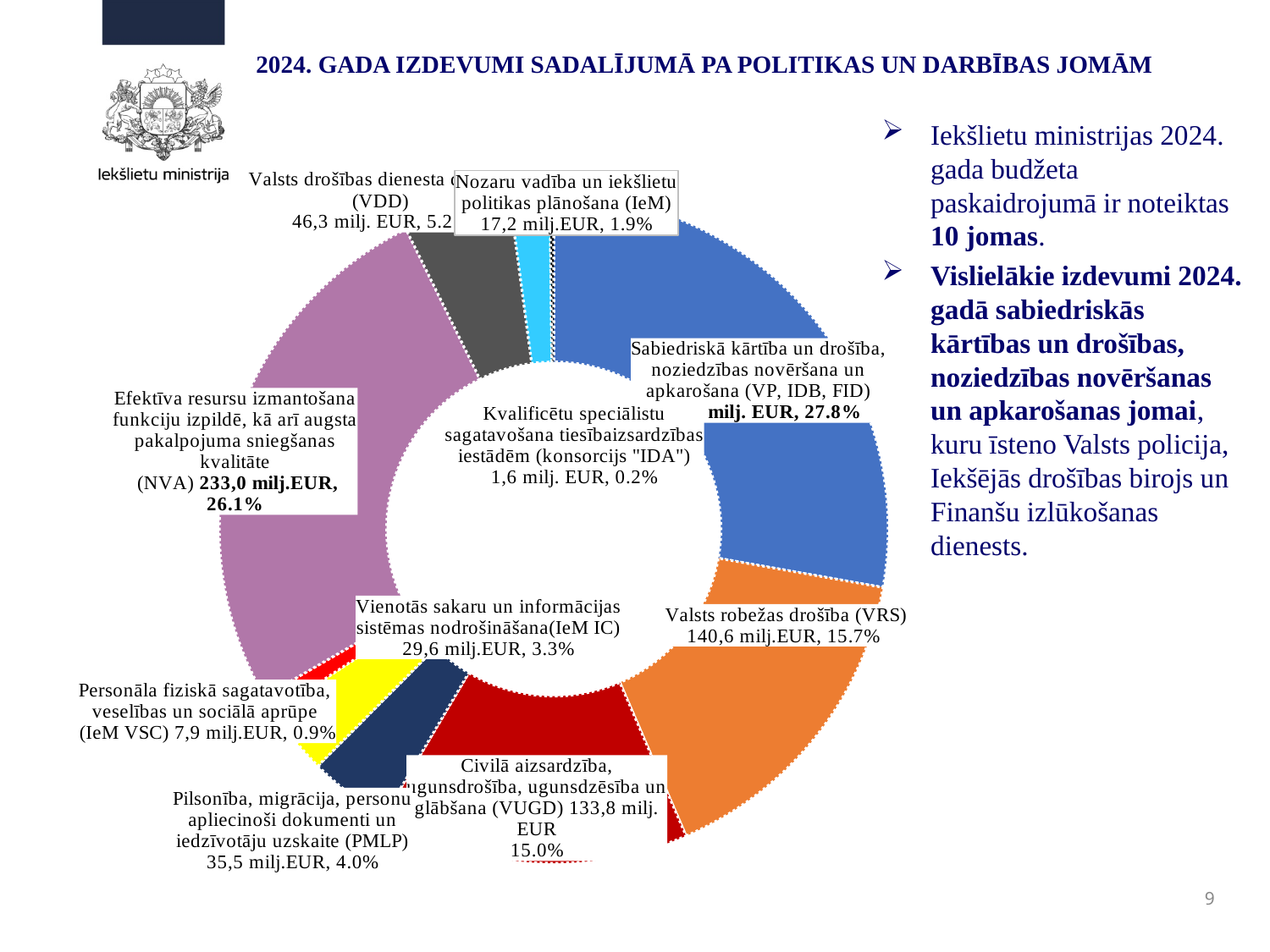
What share of 2024 expenditure goes to Valsts robežas drošība (VRS)? 15.7% What kind of chart is shown on the slide? Doughnut (pie) chart What share of expenditure goes to Efektīva resursu izmantošana funkciju izpildē (NVA)? 26.1% What is the amount in milj. EUR for Civilā aizsardzība, ugunsdrošība, ugunsdzēsība un glābšana (VUGD)? 133,8 milj. EUR What is the amount for Pilsonība, migrācija, personu apliecinoši dokumenti un iedzīvotāju uzskaite (PMLP)? 35,5 milj.EUR What share of expenditure goes to Nozaru vadība un iekšlietu politikas plānošana (IeM)? 1.9% How many segments (policy areas) does the doughnut chart show? 10 Which policy area has the smallest share of 2024 expenditure? Kvalificētu speciālistu sagatavošana tiesībaizsardzības iestādēm (konsorcijs "IDA") Which policy area has the largest share of 2024 expenditure? Sabiedriskā kārtība un drošība, noziedzības novēršana un apkarošana (VP, IDB, FID) Which has a larger share: Valsts robežas drošība (VRS) or Civilā aizsardzība (VUGD)? Valsts robežas drošība (VRS) What is the difference in milj. EUR between Valsts robežas drošība (VRS) and Civilā aizsardzība (VUGD)? 6,8 milj. EUR What is the amount in milj. EUR for Valsts robežas drošība (VRS)? 140,6 milj.EUR